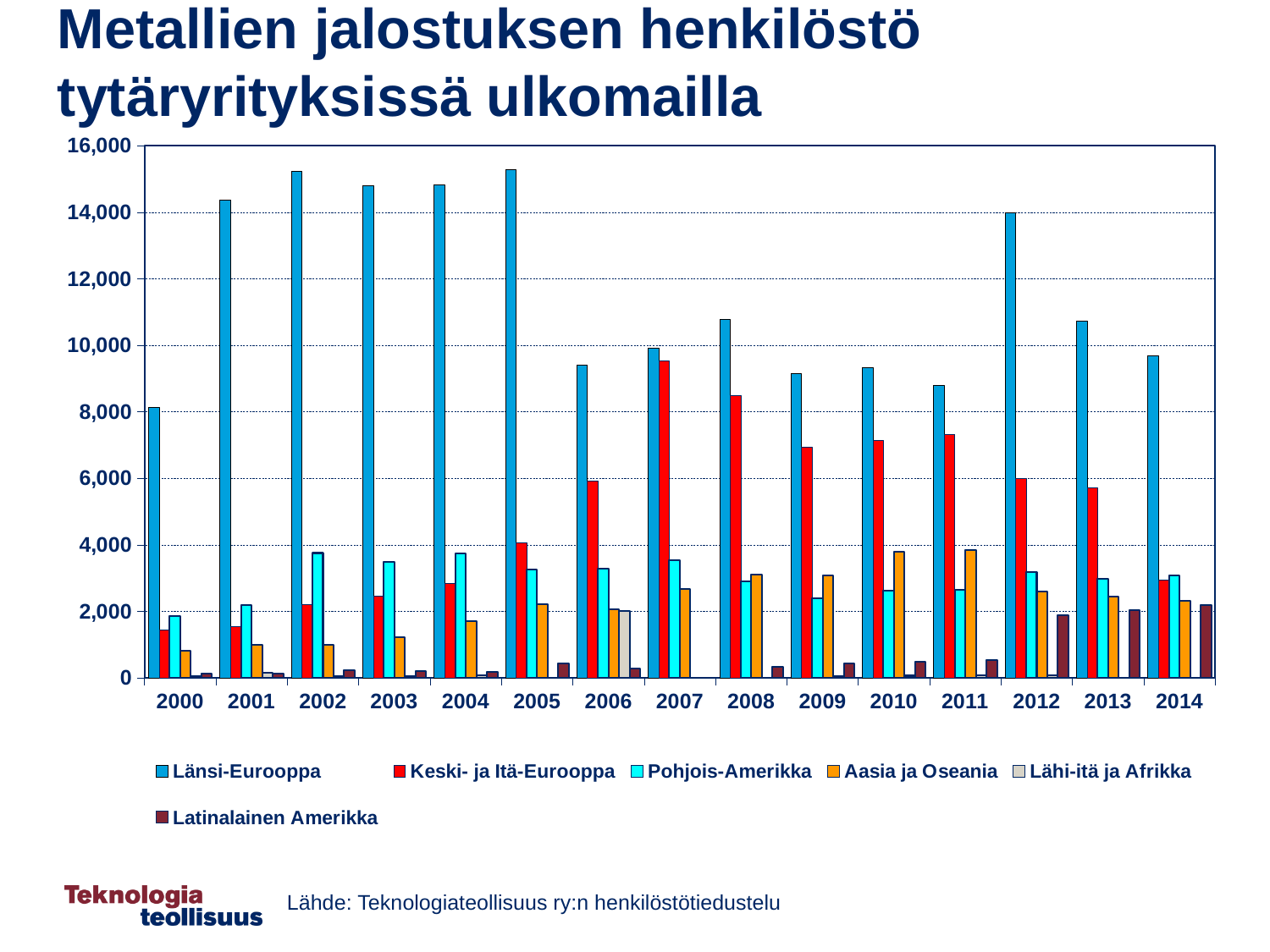
Is the value for Länsi-Eurooppa in 2012 greater or less than 12,000? greater What kind of chart is shown on the slide? bar chart How many series does the legend list? 6 In which year is the value for Länsi-Eurooppa lowest? 2000 Is the value for Aasia ja Oseania in 2011 greater or less than 2,000? greater Does the value for Keski- ja Itä-Eurooppa rise or fall from 2000 to 2007? rise How many years are shown on the x axis? 15 Is the value for Pohjois-Amerikka in 2002 greater or less than 2,000? greater In which year is the value for Keski- ja Itä-Eurooppa highest? 2007 In 2011, which is larger: Aasia ja Oseania or Pohjois-Amerikka? Aasia ja Oseania What is the title of the chart? Metallien jalostuksen henkilöstö tytäryrityksissä ulkomailla